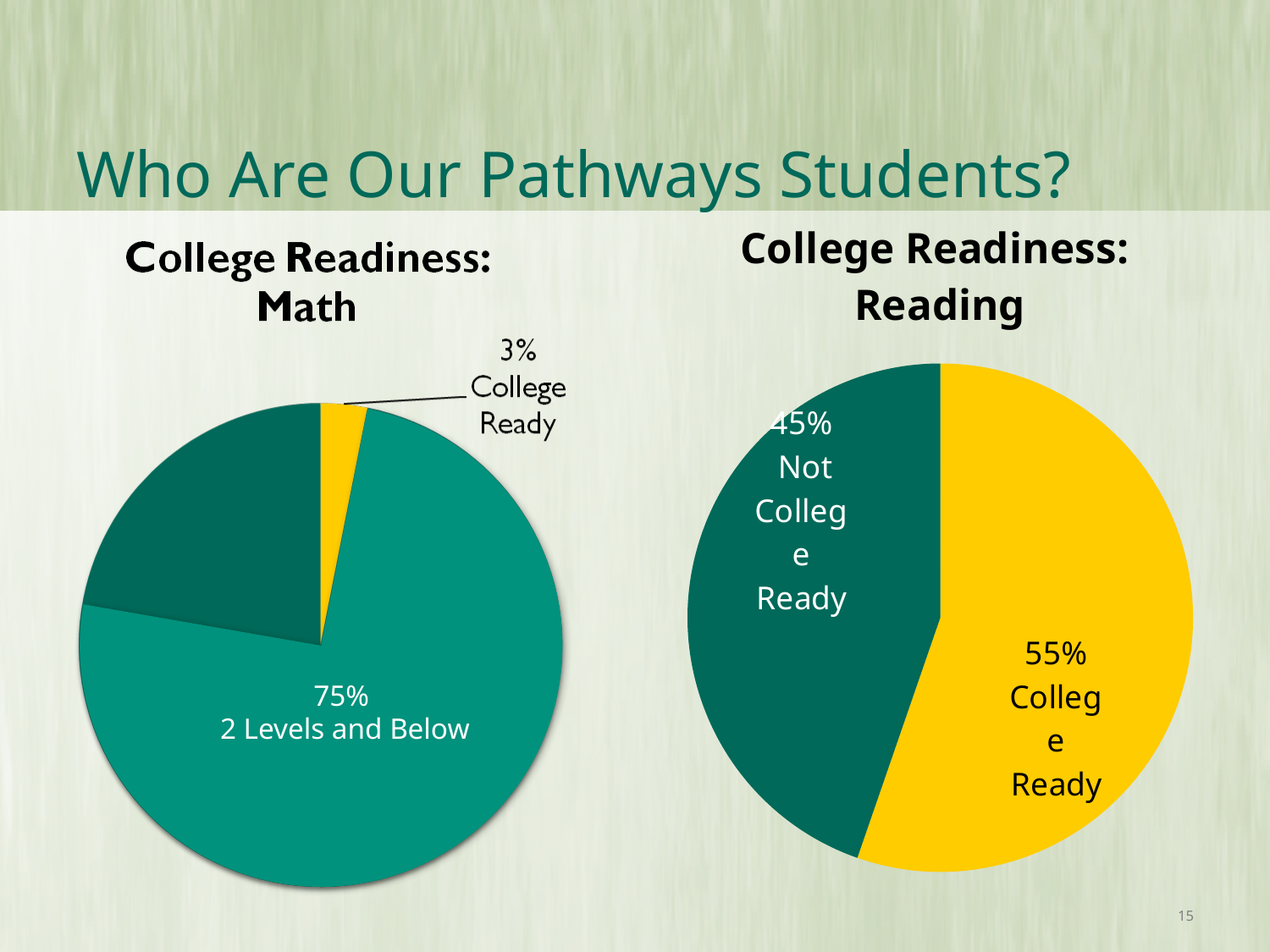
In the College Readiness: Math chart, what share of students are at 2 Levels and Below? 75% In the College Readiness: Reading chart, what is the difference between the College Ready and Not College Ready shares? 10% How many slices does the College Readiness: Math pie chart have? 3 In the College Readiness: Math chart, which labeled slice is the smallest? College Ready How many slices does the College Readiness: Reading pie chart have? 2 What kind of chart is the College Readiness: Reading chart? Pie chart In the College Readiness: Math chart, which slice is the largest? 2 Levels and Below In the College Readiness: Reading chart, what share of students are College Ready? 55% In the College Readiness: Reading chart, what share of students are Not College Ready? 45% In the College Readiness: Reading chart, which slice is larger, College Ready or Not College Ready? College Ready What is the title of the pie chart on the left side of the slide? College Readiness: Math